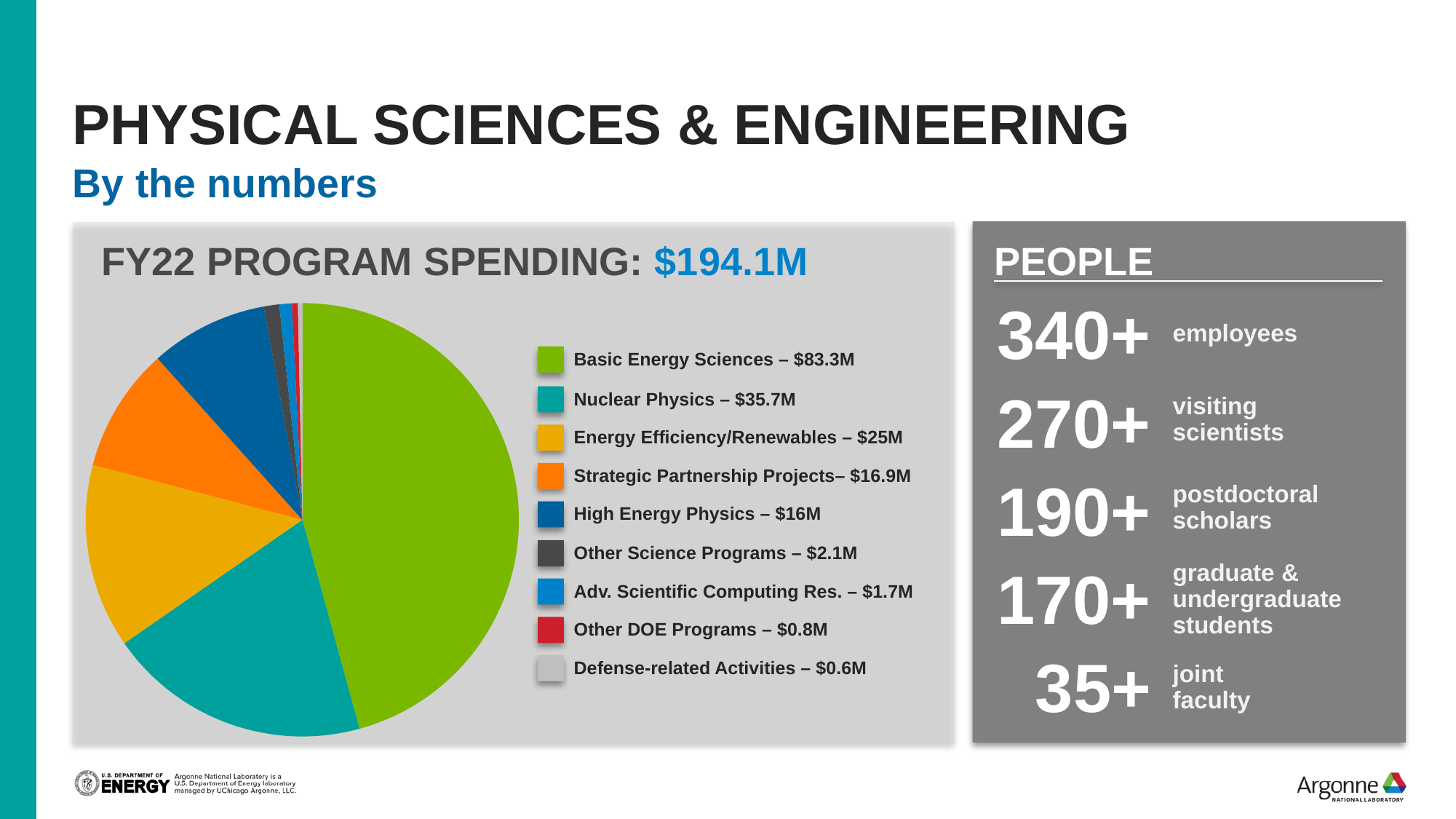
Which program has the largest share of FY22 program spending? Basic Energy Sciences What is the FY22 spending value for Nuclear Physics? $35.7M What is the FY22 spending value for Adv. Scientific Computing Res.? $1.7M How much FY22 spending went to Basic Energy Sciences? $83.3M What total FY22 program spending is stated in the pie chart's title? $194.1M What is the difference in FY22 spending between Nuclear Physics and Energy Efficiency/Renewables? $10.7M How many program categories are shown in the FY22 program spending pie chart? 9 What kind of chart is shown under FY22 Program Spending? pie chart Which received more FY22 spending, Strategic Partnership Projects or High Energy Physics? Strategic Partnership Projects What is the difference in FY22 spending between Basic Energy Sciences and Nuclear Physics? $47.6M What is the FY22 spending value for High Energy Physics? $16M Which program has the smallest FY22 spending in the pie chart? Defense-related Activities